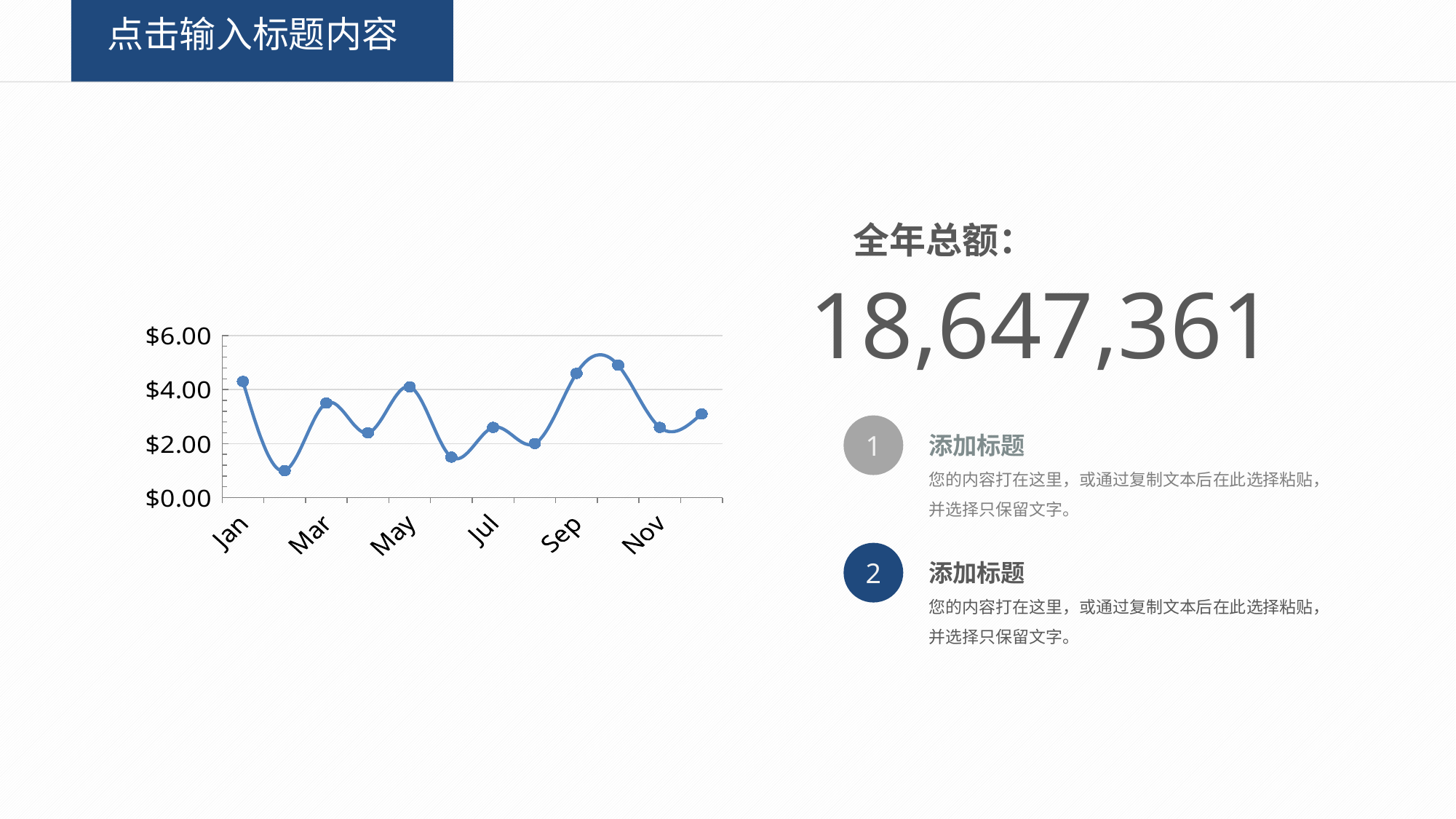
Is the value for Jul greater or less than $2.00? greater Which is larger, the value for Jul or the value for Sep? Sep What kind of chart is shown on the slide? line chart Is the value for Nov greater or less than $4.00? less Which is larger, the value for Sep or the value for Nov? Sep Which is larger, the value for Jan or the value for Mar? Jan What is the highest value label shown on the vertical axis of the chart? $6.00 How many data points are plotted on the line chart? 12 Is the value for Sep greater or less than $4.00? greater Does the value rise or fall from Sep to Nov? fall